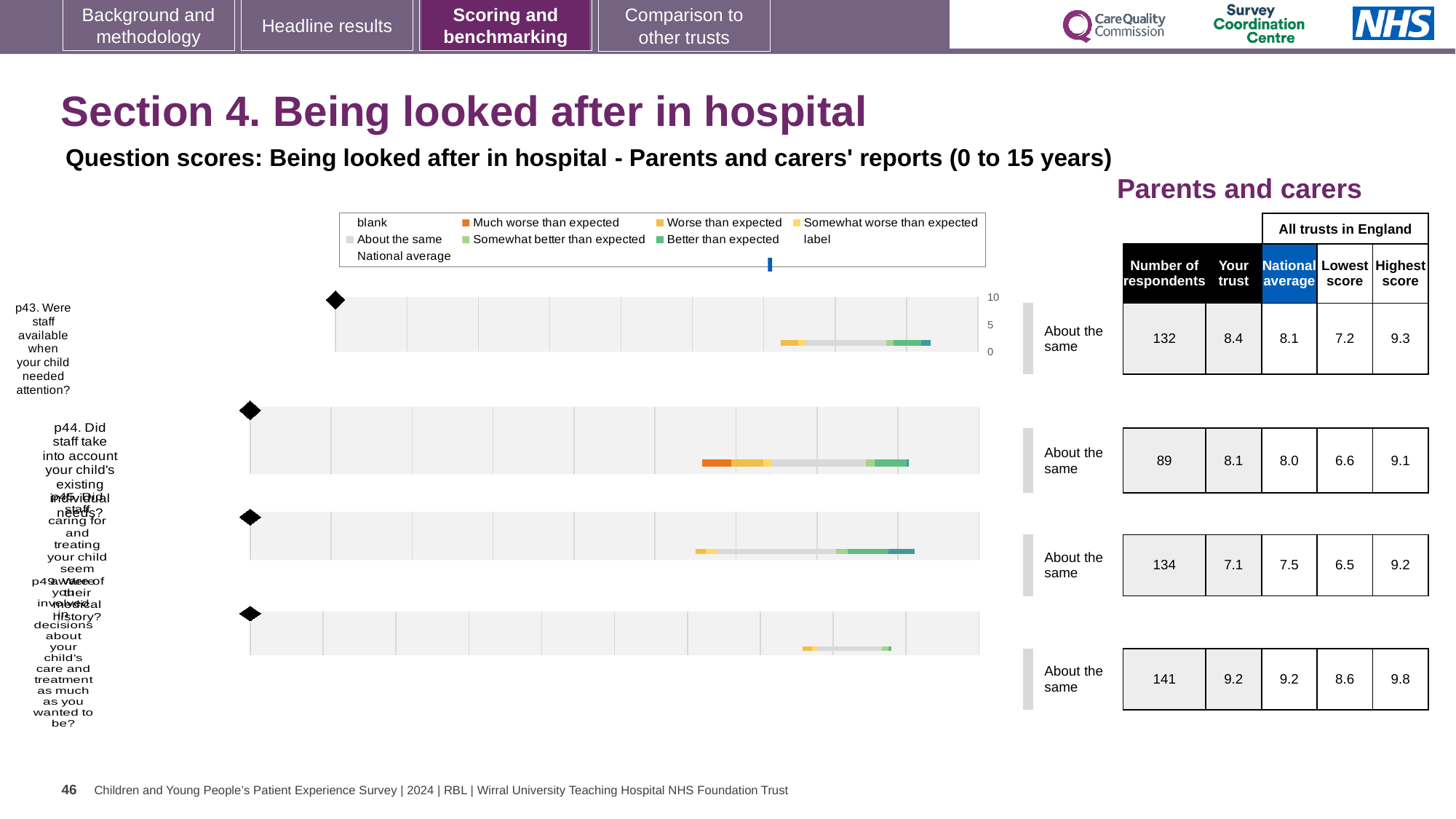
Which of the four questions has the highest 'Your trust' score? the bottom one (9.2) What is the Highest score listed for the p44 question? 9.1 For the p43 question, which is larger: the 'Your trust' score or the National average? Your trust In the table next to the p43 chart, what is the 'Your trust' score? 8.4 What kind of chart is used for the p43 question on this slide? bar chart For the p43 question, what is the difference between the 'Your trust' score and the National average? 0.3 How many question charts are shown on the slide? 4 For the third chart from the top, which is larger: the 'Your trust' score or the National average? National average According to the legend, what colour represents 'Much worse than expected'? orange What is the Lowest score listed for the p43 question? 7.2 How many respondents are listed for the p44 question? 89 In the table next to the p43 chart, what is the National average score? 8.1